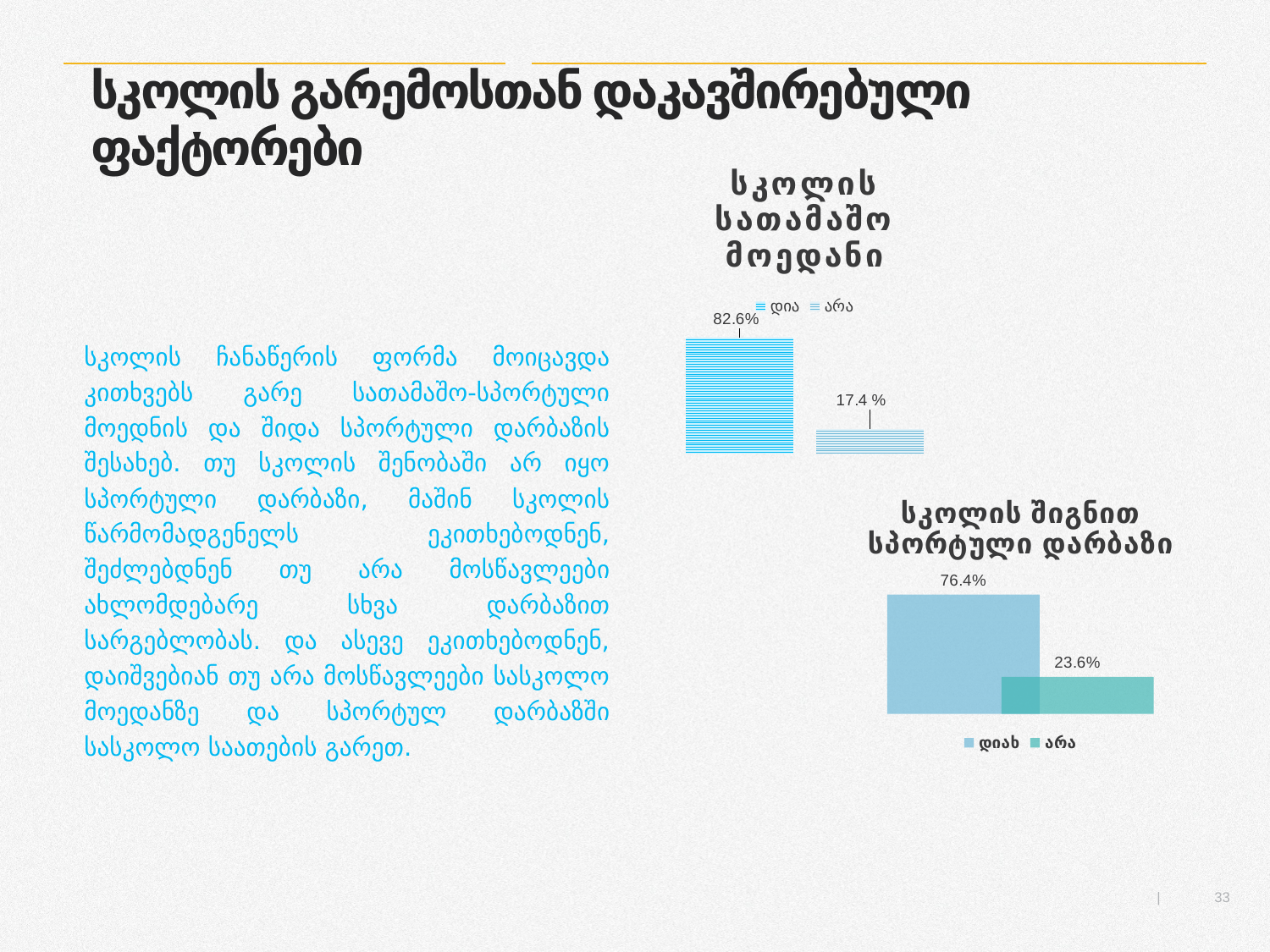
In the bottom-right chart titled "სკოლის შიგნით სპორტული დარბაზი", what is the difference between the values for "დიახ" and "არა"? 52.8% In the top-right chart titled "სკოლის სათამაშო მოედანი", what is the value for "არა"? 17.4 % In the top-right chart titled "სკოლის სათამაშო მოედანი", which category has the highest value? დია In the bottom-right chart titled "სკოლის შიგნით სპორტული დარბაზი", which is larger, "დიახ" or "არა"? დიახ In the bottom-right chart titled "სკოლის შიგნით სპორტული დარბაზი", which category has the lowest value? არა In the bottom-right chart titled "სკოლის შიგნით სპორტული დარბაზი", what is the value for "დიახ"? 76.4% How many charts are shown on the slide? 2 What type of chart is the bottom-right chart titled "სკოლის შიგნით სპორტული დარბაზი"? Bar chart In the bottom-right chart titled "სკოლის შიგნით სპორტული დარბაზი", what is the value for "არა"? 23.6% In the top-right chart titled "სკოლის სათამაშო მოედანი", what is the difference between the values for "დია" and "არა"? 65.2% How many series does the legend of the top-right chart titled "სკოლის სათამაშო მოედანი" list? 2 In the top-right chart titled "სკოლის სათამაშო მოედანი", what is the value for "დია"? 82.6%